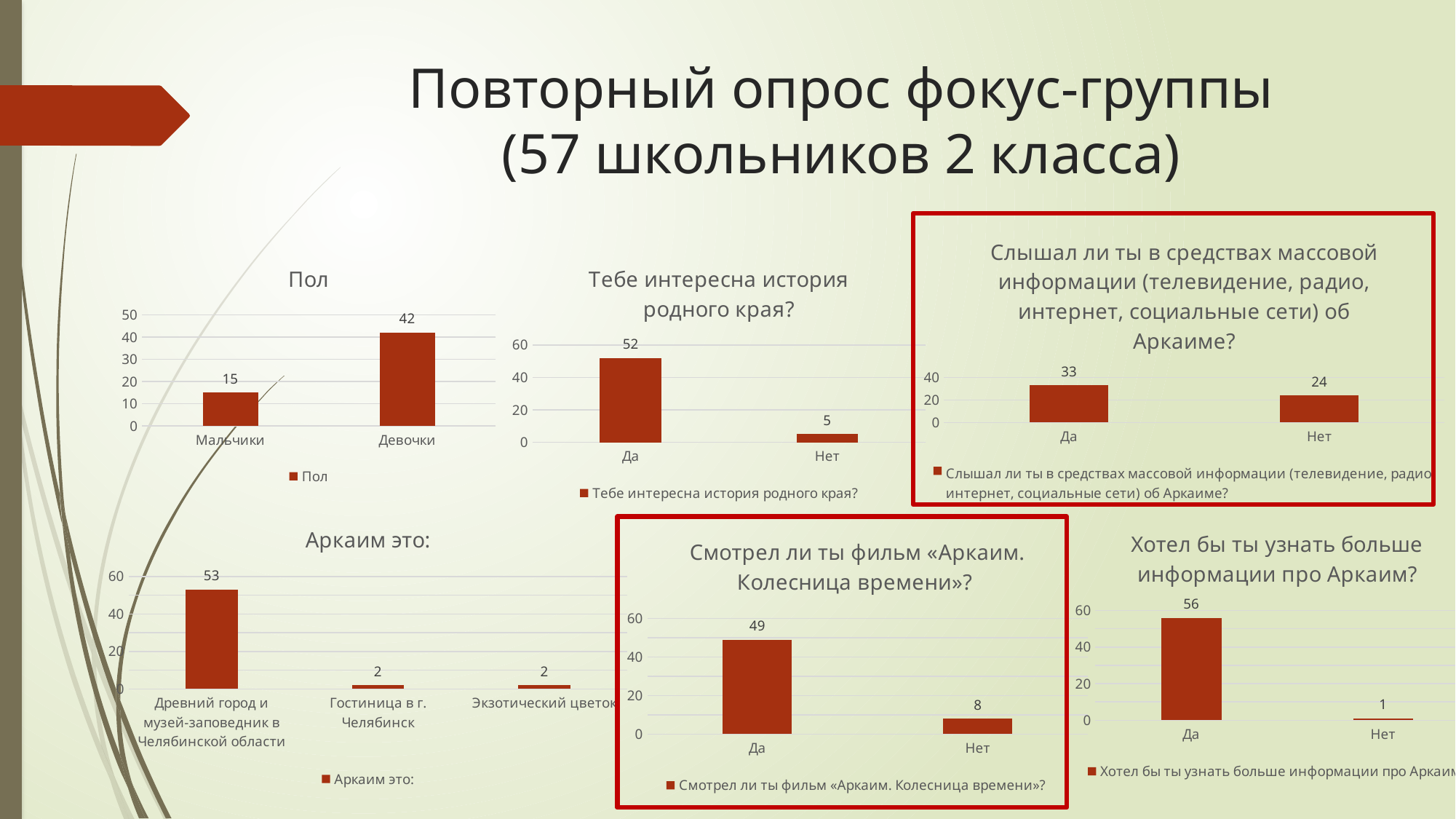
In the "Тебе интересна история родного края?" chart, which category is highest? Да In the "Аркаим это:" chart, what is the value for Гостиница в г. Челябинск? 2 What kind of chart is the "Хотел бы ты узнать больше информации про Аркаим?" chart? bar chart In the "Слышал ли ты в средствах массовой информации (телевидение, радио, интернет, социальные сети) об Аркаиме?" chart, what is the difference between Да and Нет? 9 In the "Пол" chart, what is the difference between Девочки and Мальчики? 27 In the "Слышал ли ты в средствах массовой информации (телевидение, радио, интернет, социальные сети) об Аркаиме?" chart, what is the value for Да? 33 In the "Хотел бы ты узнать больше информации про Аркаим?" chart, what is the value for Нет? 1 In the "Смотрел ли ты фильм «Аркаим. Колесница времени»?" chart, which is larger, Да or Нет? Да In the "Аркаим это:" chart, how many categories are shown? 3 In the "Тебе интересна история родного края?" chart, what is the value for Нет? 5 In the "Пол" chart, what is the value for Девочки? 42 In the "Смотрел ли ты фильм «Аркаим. Колесница времени»?" chart, what is the value for Да? 49